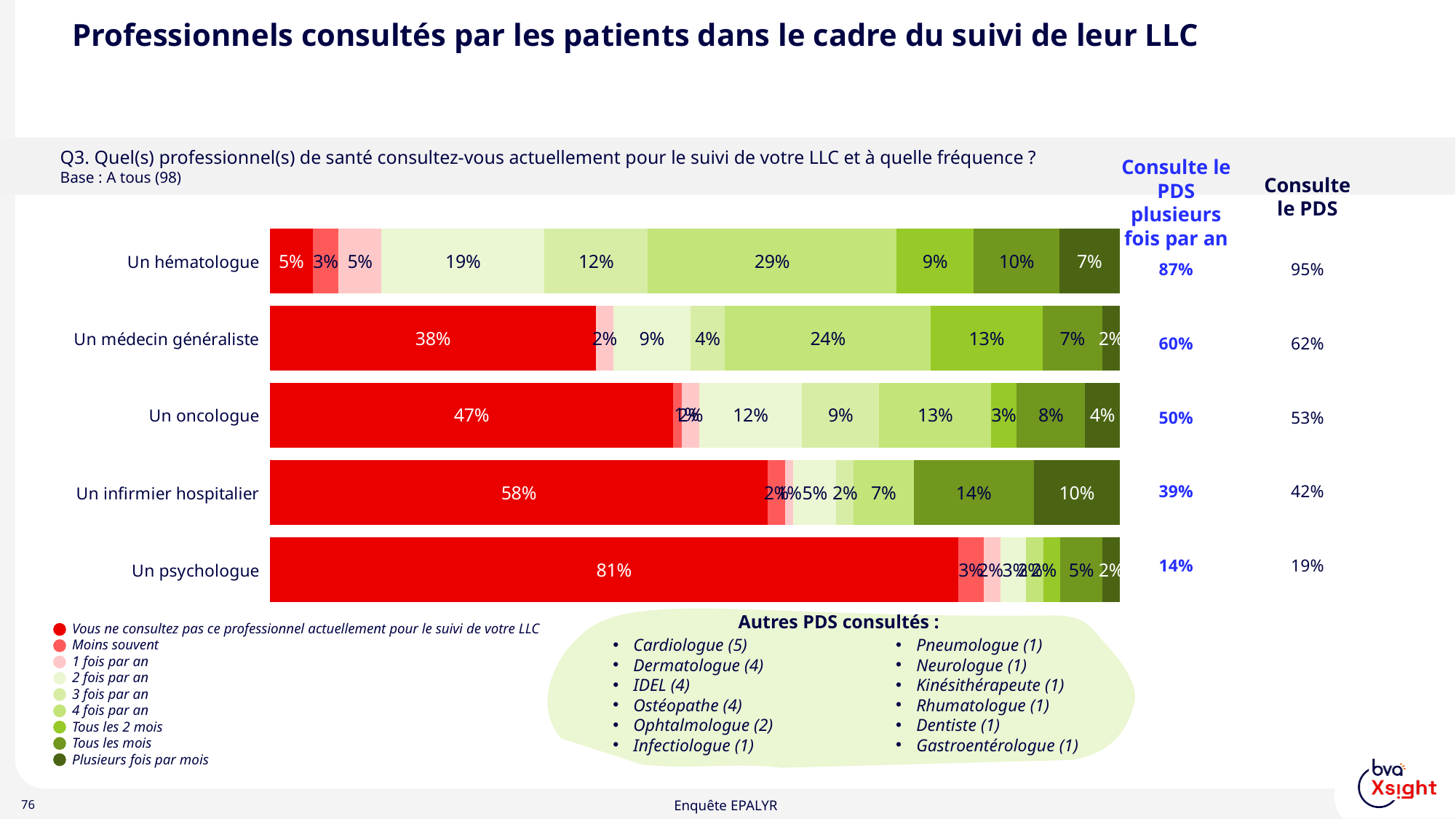
What kind of chart is used to show the professionals consulted by patients? Stacked bar chart In the 'Consulte le PDS' column, what is the value for Un oncologue? 53% Which professional has the highest share of patients who do not consult them (red segment)? Un psychologue Which has a larger 'Tous les mois' share: Un hématologue or Un médecin généraliste? Un hématologue What percentage of patients consult a hematologist (Un hématologue) 4 fois par an? 29% What percentage of patients consult a hospital nurse (Un infirmier hospitalier) 'Tous les mois'? 14% What colour represents 'Vous ne consultez pas ce professionnel actuellement pour le suivi de votre LLC' in the legend? Red What is the difference in percentage points between the 'not consulted' share for Un psychologue and for Un infirmier hospitalier? 23 percentage points How many series does the legend list? 9 How many health professionals (categories) are shown in the chart? 5 Which professional has the lowest share of patients who do not consult them (red segment)? Un hématologue What percentage of patients do not currently consult a general practitioner (Un médecin généraliste) for their LLC follow-up? 38%